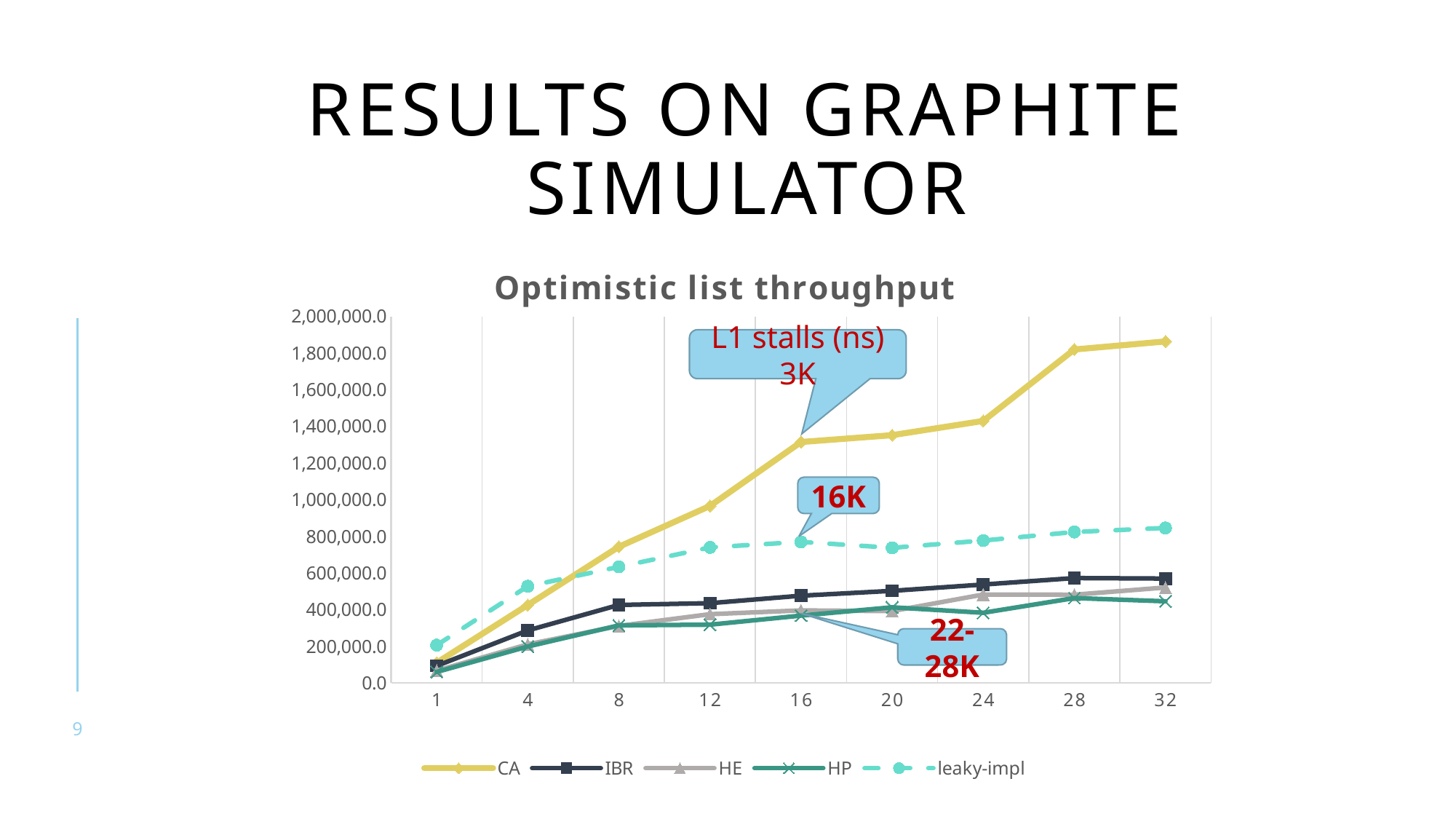
Is the value for leaky-impl at x = 32 greater or less than 800,000.0? greater How many points are on the x axis of the chart? 9 Is the value for CA at x = 32 greater or less than 1,800,000.0? greater At x = 4, which is larger: CA or leaky-impl? leaky-impl Which series has the highest value at x = 32? CA Does the CA series rise or fall as x increases from 1 to 32? rise Is the value for CA at x = 16 greater or less than 1,200,000.0? greater What kind of chart is shown on the slide? line chart Which series has the lowest value at x = 32? HP Which series has the highest value at x = 1? leaky-impl How many series does the legend list? 5 What is the title of the chart? Optimistic list throughput